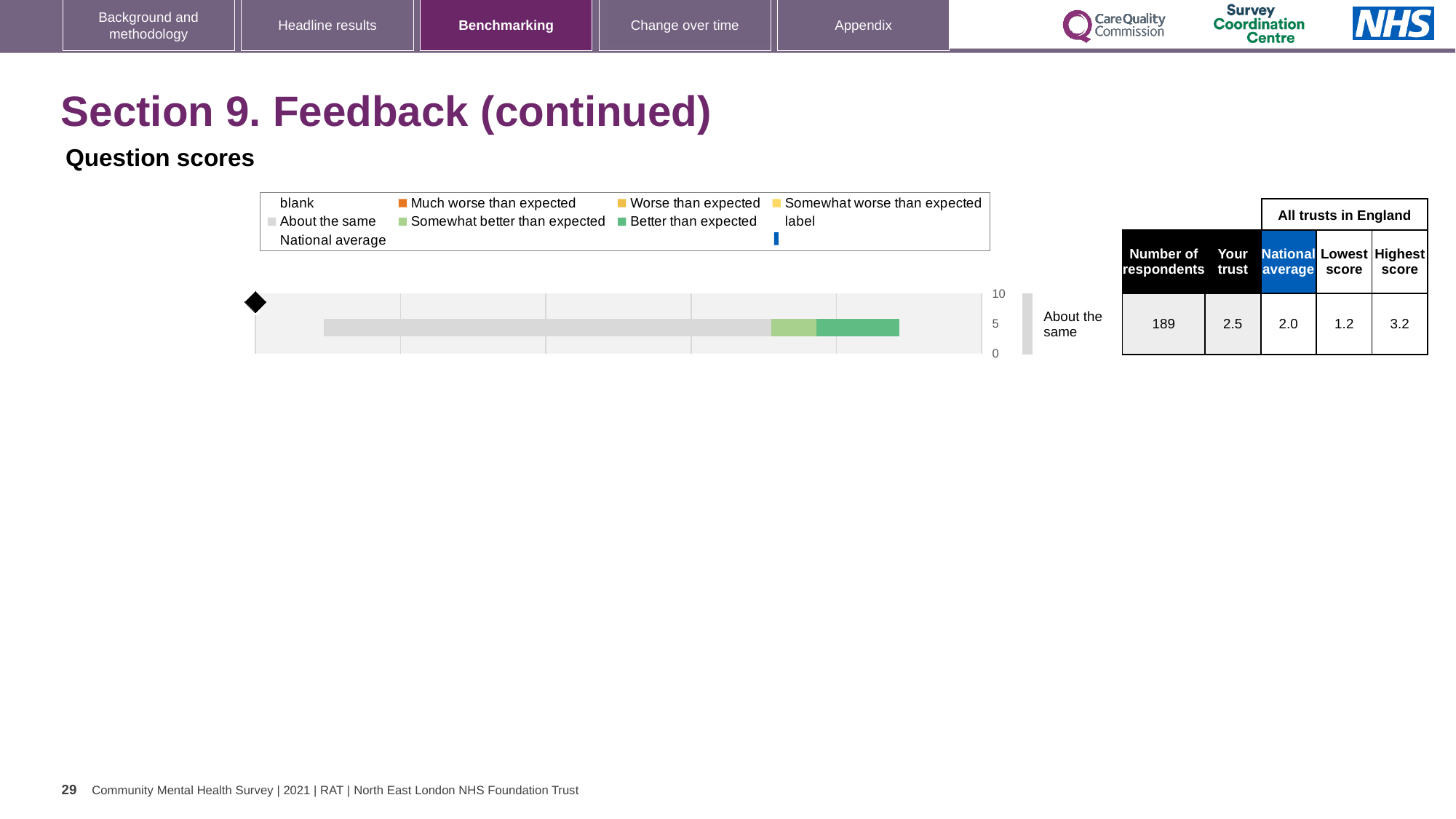
How many bars are plotted in the chart? 1 What is the difference between the highest score and the lowest score for 'About the same' in the table? 2.0 According to the table next to the chart, what is the highest score among all trusts in England for 'About the same'? 3.2 What is the category label of the bar in the chart? About the same According to the table next to the chart, what is the lowest score among all trusts in England for 'About the same'? 1.2 What is the difference between the 'Your trust' score and the national average for 'About the same'? 0.5 Which is larger for 'About the same': the 'Your trust' score or the national average score? Your trust What kind of chart is shown on the slide? bar chart What is the highest tick value shown on the chart's axis? 10 According to the table next to the chart, what is the national average score for 'About the same'? 2.0 According to the table next to the chart, what is the 'Your trust' score for 'About the same'? 2.5 According to the table next to the chart, what is the number of respondents for 'About the same'? 189